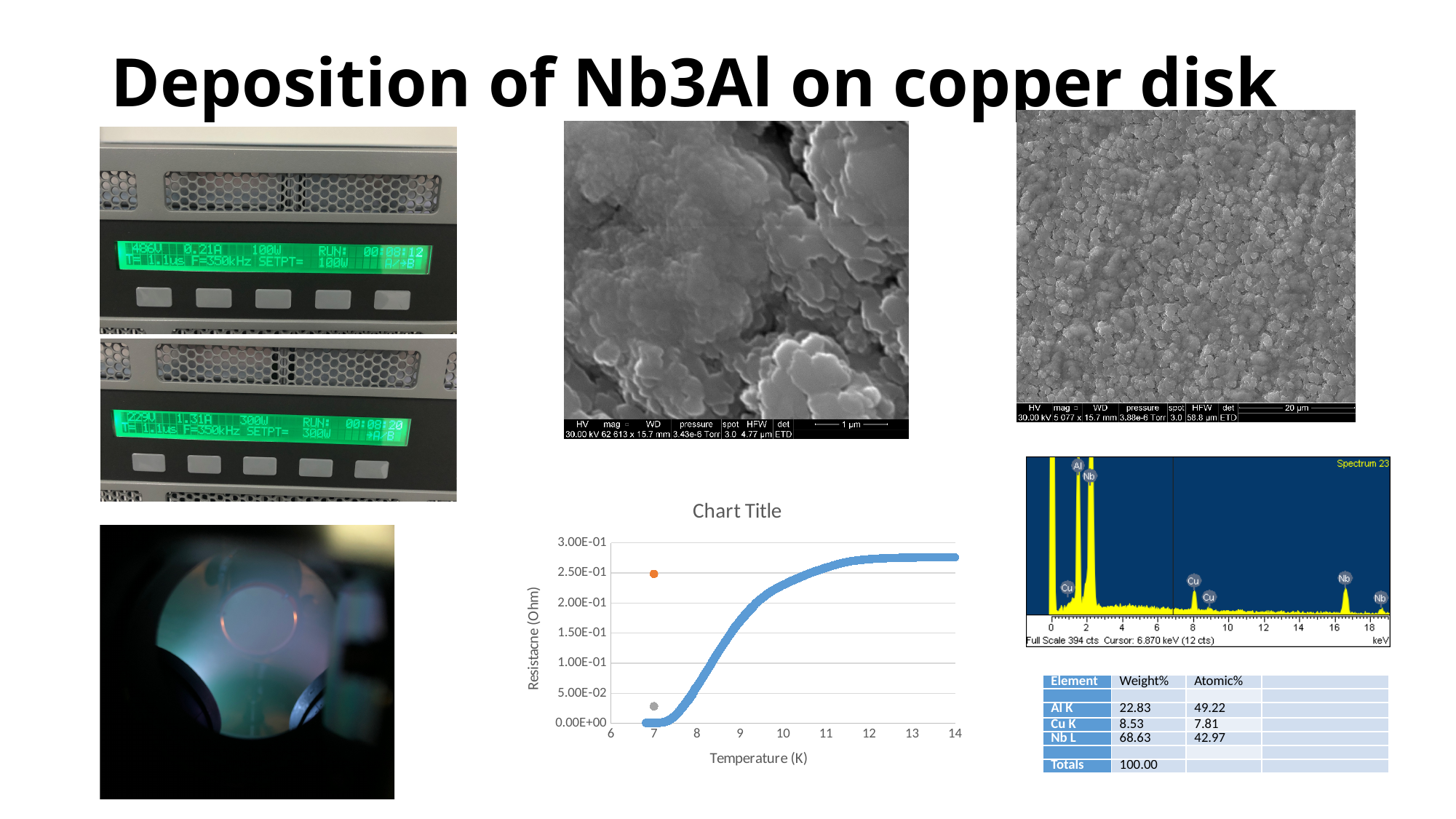
In the chart, is the blue series value at 12 K greater or less than 2.50E-01? greater What is the title of the chart on the slide? Chart Title In the chart, do the blue values rise or fall as temperature increases from 7 K to 14 K? rise In the chart, is the blue series value at 9 K greater or less than 1.00E-01? greater What kind of chart is the chart titled "Chart Title"? scatter chart In the chart, which is larger at about 7 K: the orange point or the gray point? the orange point What is the label of the y axis of the chart? Resistacne (Ohm) In the chart, is the blue series value at 8 K greater or less than 1.00E-01? less